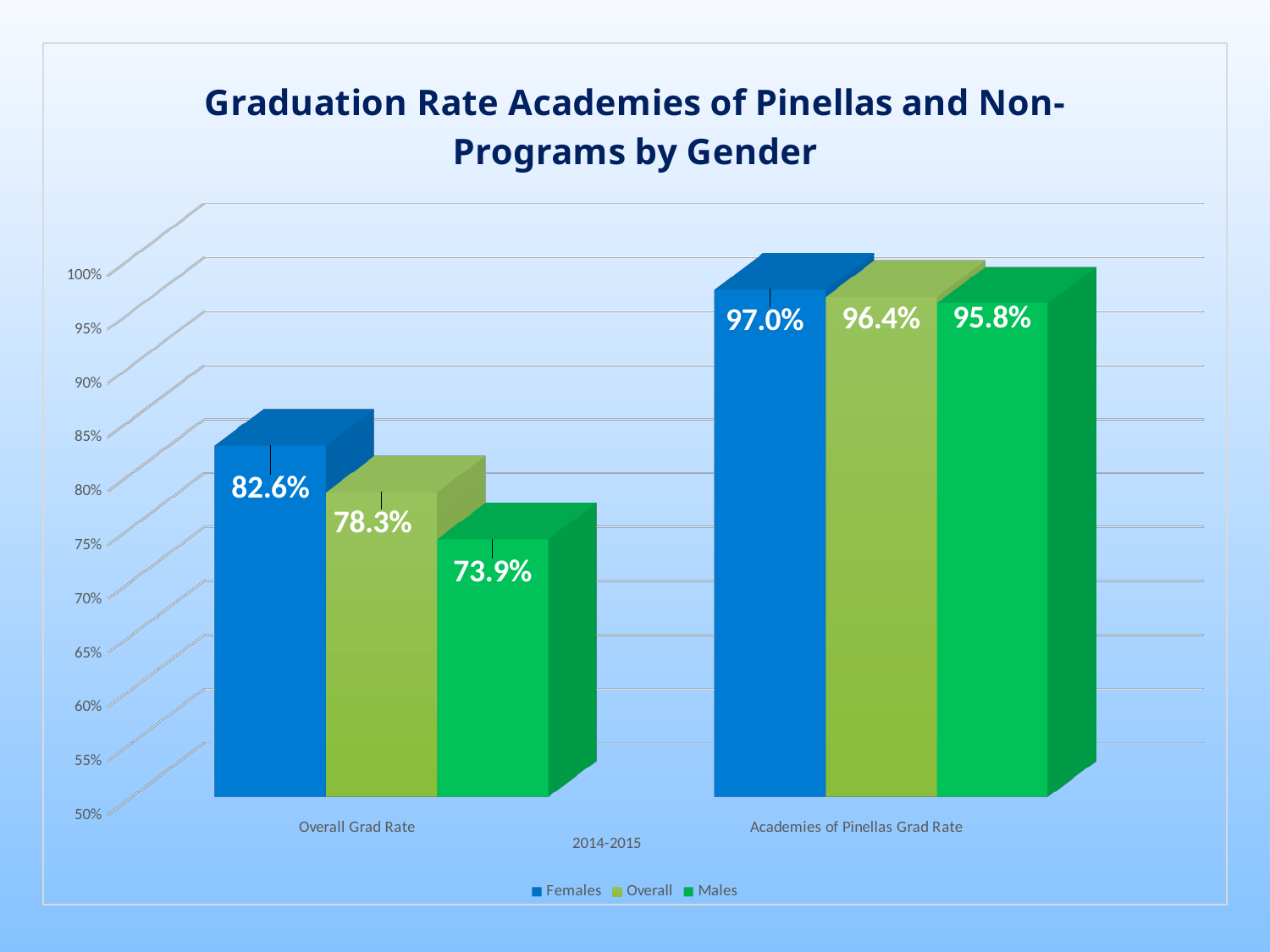
Which series has the highest value for Academies of Pinellas Grad Rate? Females How many series does the legend list? 3 What is the Males graduation rate for Academies of Pinellas Grad Rate? 95.8% What is the Females graduation rate for Overall Grad Rate? 82.6% Which series has the lowest value for Overall Grad Rate? Males Is the Overall value for Overall Grad Rate larger or smaller than the Overall value for Academies of Pinellas Grad Rate? smaller What is the difference between the Females values for Academies of Pinellas Grad Rate and Overall Grad Rate? 14.4% What is the title of the chart? Graduation Rate Academies of Pinellas and Non-Programs by Gender What kind of chart is shown on the slide? bar chart What is the difference between the Females and Males values for Overall Grad Rate? 8.7% What is the Males value for Overall Grad Rate? 73.9% What is the Overall value for Academies of Pinellas Grad Rate? 96.4%